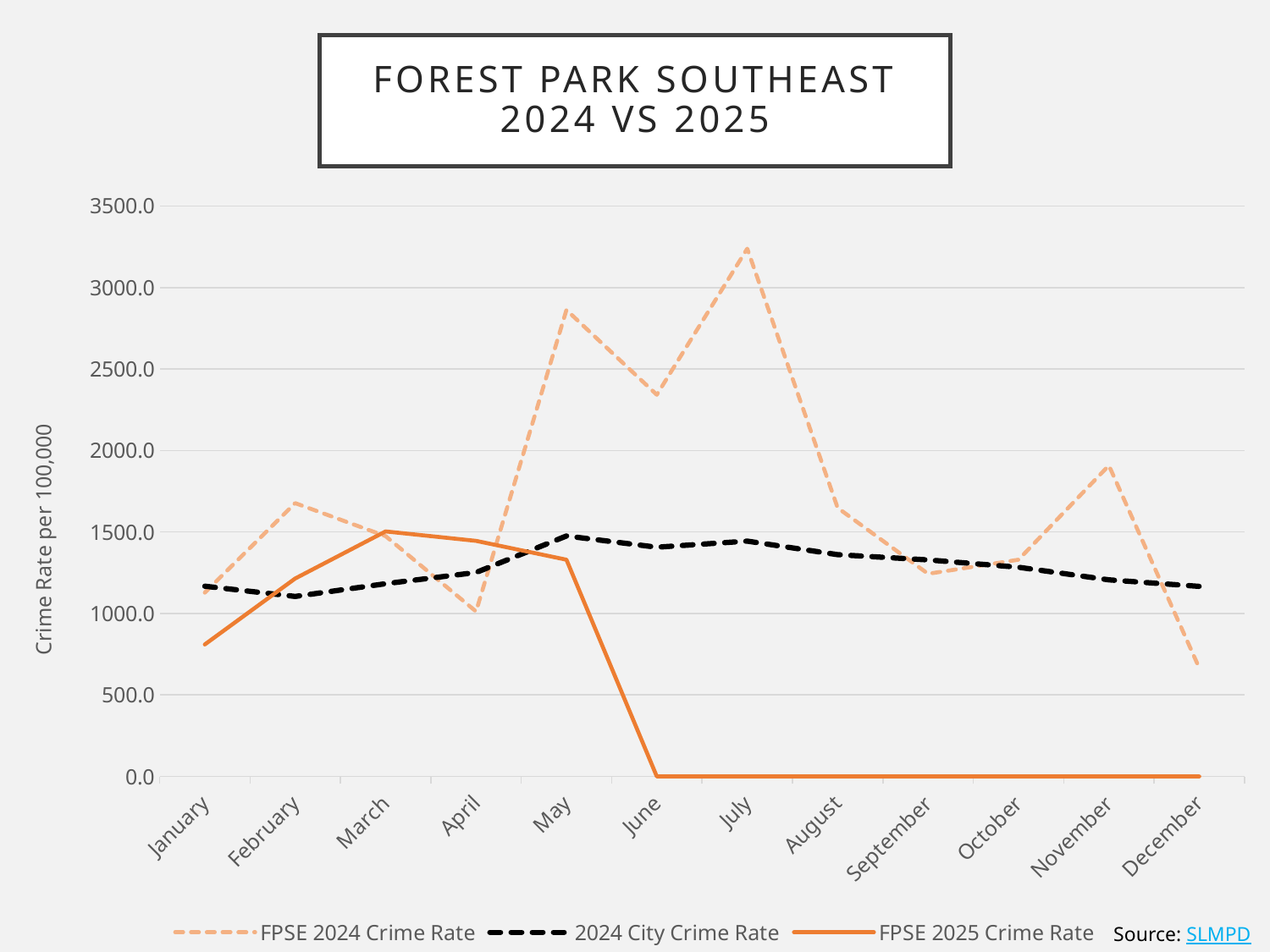
How many series does the legend list? 3 In which month is the FPSE 2024 Crime Rate lowest? December In May, which is larger: the FPSE 2024 Crime Rate or the 2024 City Crime Rate? FPSE 2024 Crime Rate Is the FPSE 2024 Crime Rate for July greater or less than 3000? greater What is the label on the y axis? Crime Rate per 100,000 What is the FPSE 2025 Crime Rate value for June? 0.0 In which month is the FPSE 2025 Crime Rate highest? March What kind of chart is shown on the slide? Line chart In which month is the FPSE 2024 Crime Rate highest? July Does the FPSE 2025 Crime Rate rise or fall from May to June? Fall How many months are shown along the x axis? 12 Is the FPSE 2025 Crime Rate for January greater or less than 1000? less